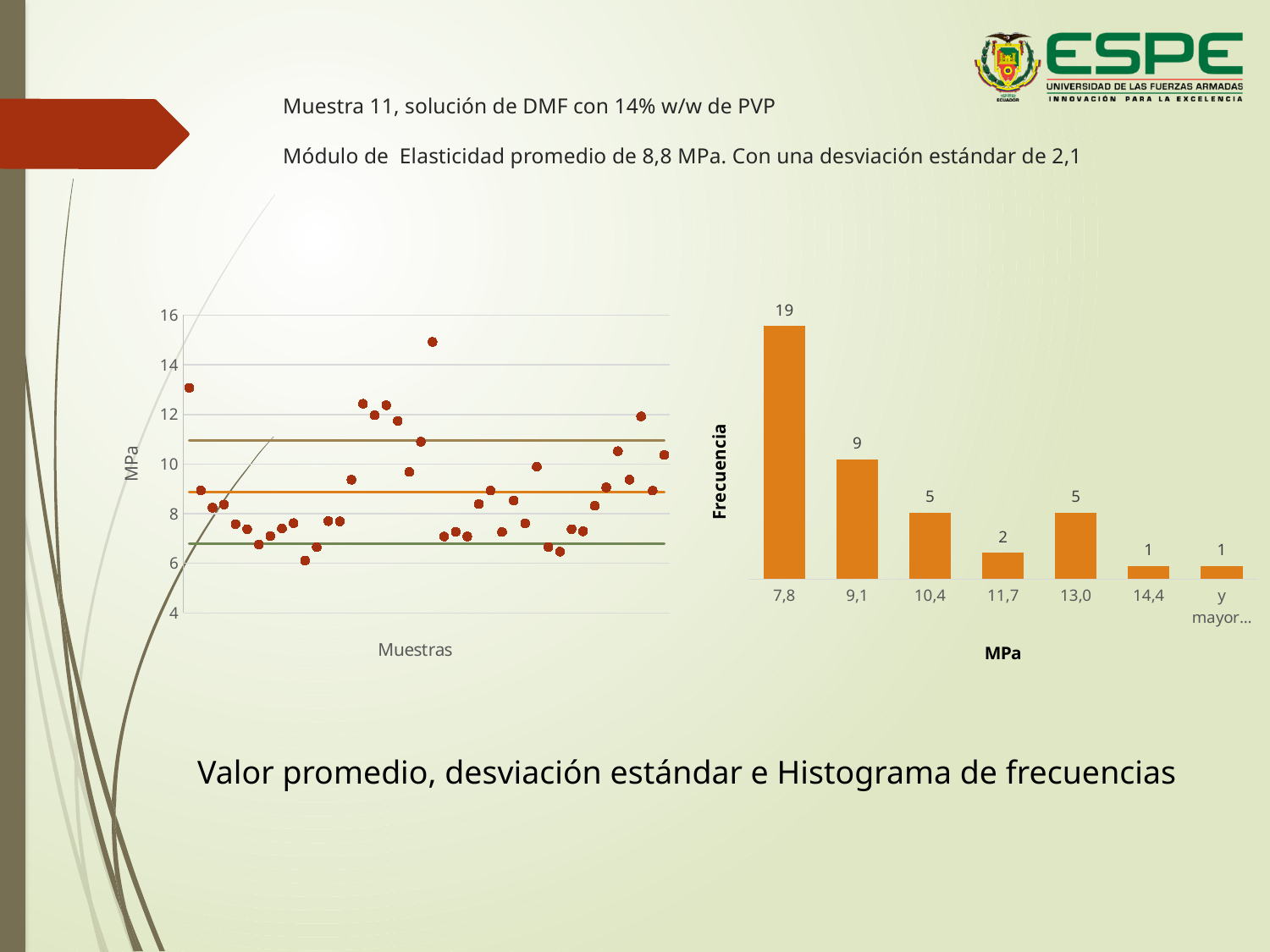
How many bins (bars) does the histogram on the right show? 7 In the histogram on the right, what is the difference in frequency between the 7,8 bin and the 9,1 bin? 10 What kind of chart is the chart on the left (MPa vs Muestras)? Scatter chart In the histogram on the right, what is the frequency for the 13,0 MPa bin? 5 In the scatter chart on the left, is the highest plotted point greater or less than 14 MPa? greater In the histogram on the right, which bin has the highest frequency? 7,8 What is the total of all the frequencies shown in the histogram on the right? 42 In the histogram on the right, which bin has a higher frequency, 9,1 or 13,0? 9,1 In the histogram on the right, what is the difference in frequency between the 10,4 bin and the 11,7 bin? 3 In the histogram on the right, what is the frequency for the 11,7 MPa bin? 2 In the histogram on the right, what is the frequency for the 7,8 MPa bin? 19 What is the label of the vertical axis of the histogram on the right? Frecuencia